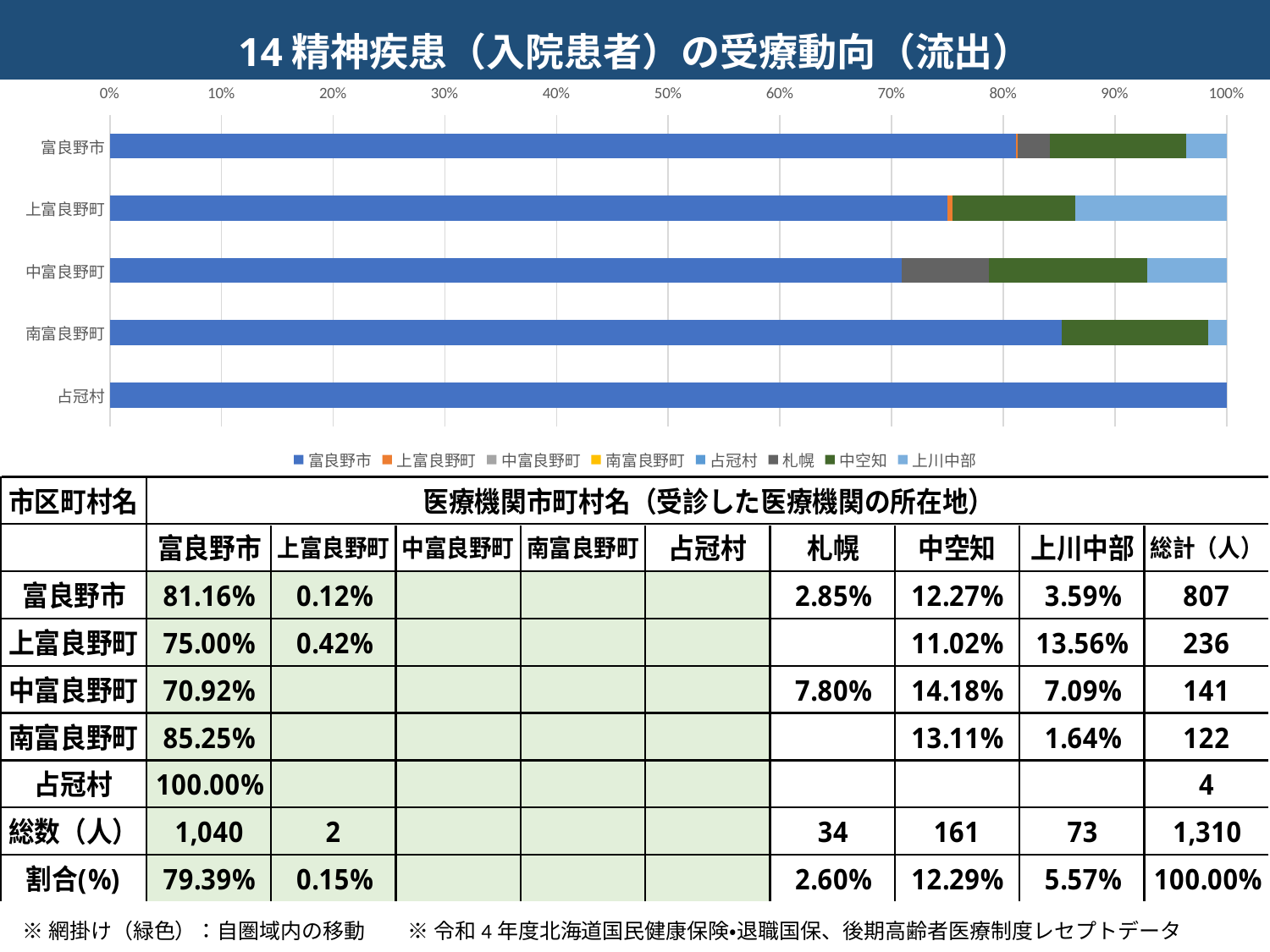
Which municipality has the largest 富良野市 segment in its bar? 占冠村 Which municipality has the smallest 富良野市 segment in its bar? 中富良野町 What is the difference between the 上川中部 share for 上富良野町 and for 富良野市? 9.97% What kind of chart is shown on the slide? bar chart What is the title of the chart? 14 精神疾患（入院患者）の受療動向（流出） Which has the larger 中空知 segment, 中富良野町 or 富良野市? 中富良野町 What is the 札幌 share for the 中富良野町 bar? 7.80% What is the 富良野市 share for the 富良野市 bar? 81.16% How many series does the chart legend list? 8 Is the 富良野市 segment for 南富良野町 greater or less than 80%? greater How many municipalities (categories) are plotted on the y axis of the chart? 5 Is the 富良野市 segment for 上富良野町 greater or less than 80%? less